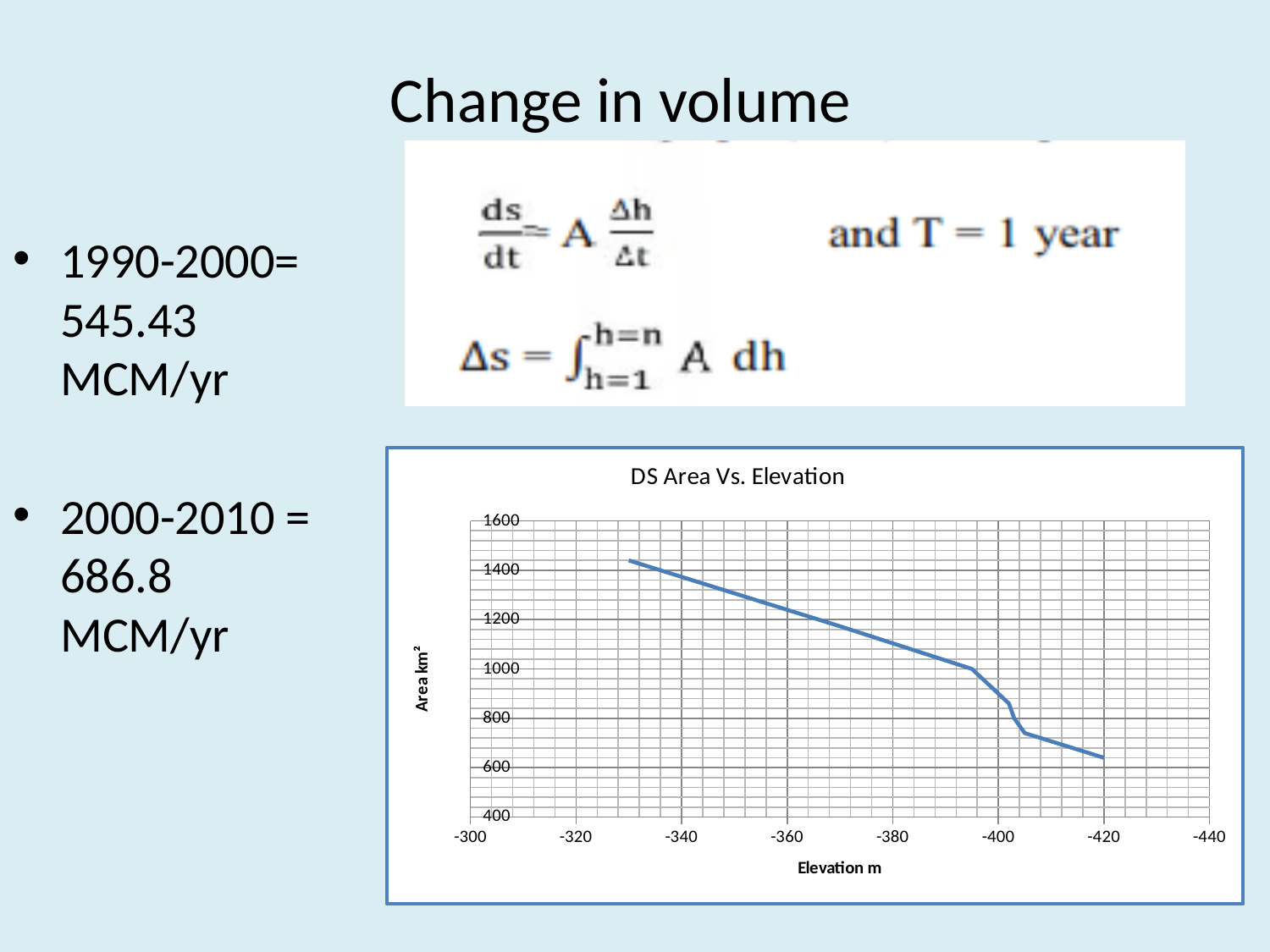
In the DS Area Vs. Elevation chart, is the area larger at an elevation of -340 m or at -400 m? -340 m What kind of chart is the DS Area Vs. Elevation chart? line chart In the DS Area Vs. Elevation chart, is the area at an elevation of -400 m greater or less than 1000? less In the DS Area Vs. Elevation chart, is the area at an elevation of -380 m greater or less than 1000? greater In the DS Area Vs. Elevation chart, is the area at an elevation of -340 m greater or less than 1200? greater What is the title of the chart on the slide? DS Area Vs. Elevation What is the highest value shown on the vertical axis of the DS Area Vs. Elevation chart? 1600 What is the lowest value shown on the vertical axis of the DS Area Vs. Elevation chart? 400 In the DS Area Vs. Elevation chart, does the area rise or fall as you move from left to right along the elevation axis? fall What is the label of the vertical axis of the DS Area Vs. Elevation chart? Area km²